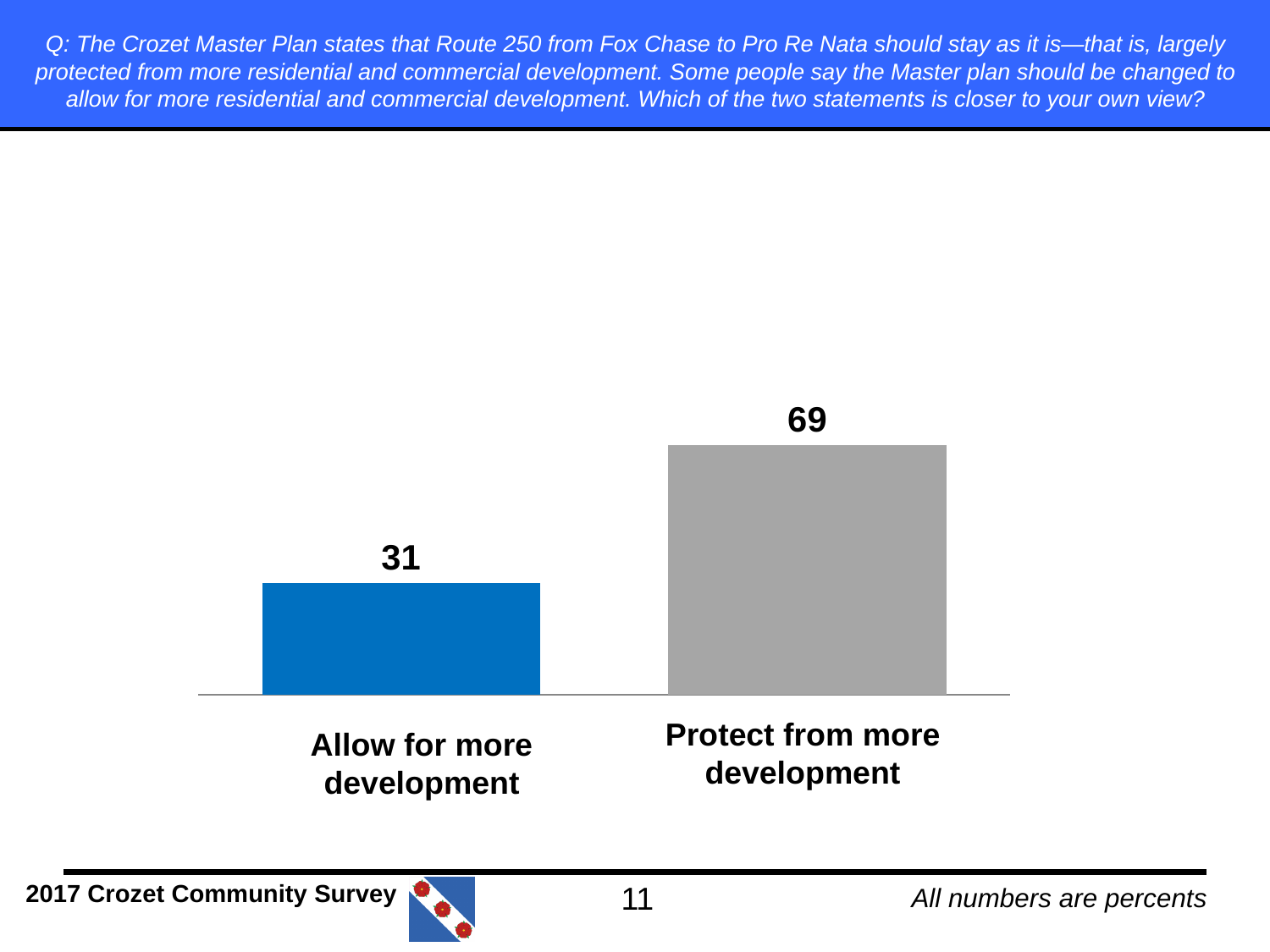
What is the value for "Protect from more development"? 69 What is the total of the two values shown in the chart? 100 According to the footer, what unit are the numbers on the chart in? Percents What kind of chart is shown on the slide? Bar chart Which category has the lowest value? Allow for more development How many categories are shown in the chart? 2 Which category has the highest value? Protect from more development What is the difference between the values for "Protect from more development" and "Allow for more development"? 38 Which is larger: the value for "Allow for more development" or "Protect from more development"? Protect from more development What is the value for "Allow for more development"? 31 What colour is the bar for "Allow for more development"? Blue